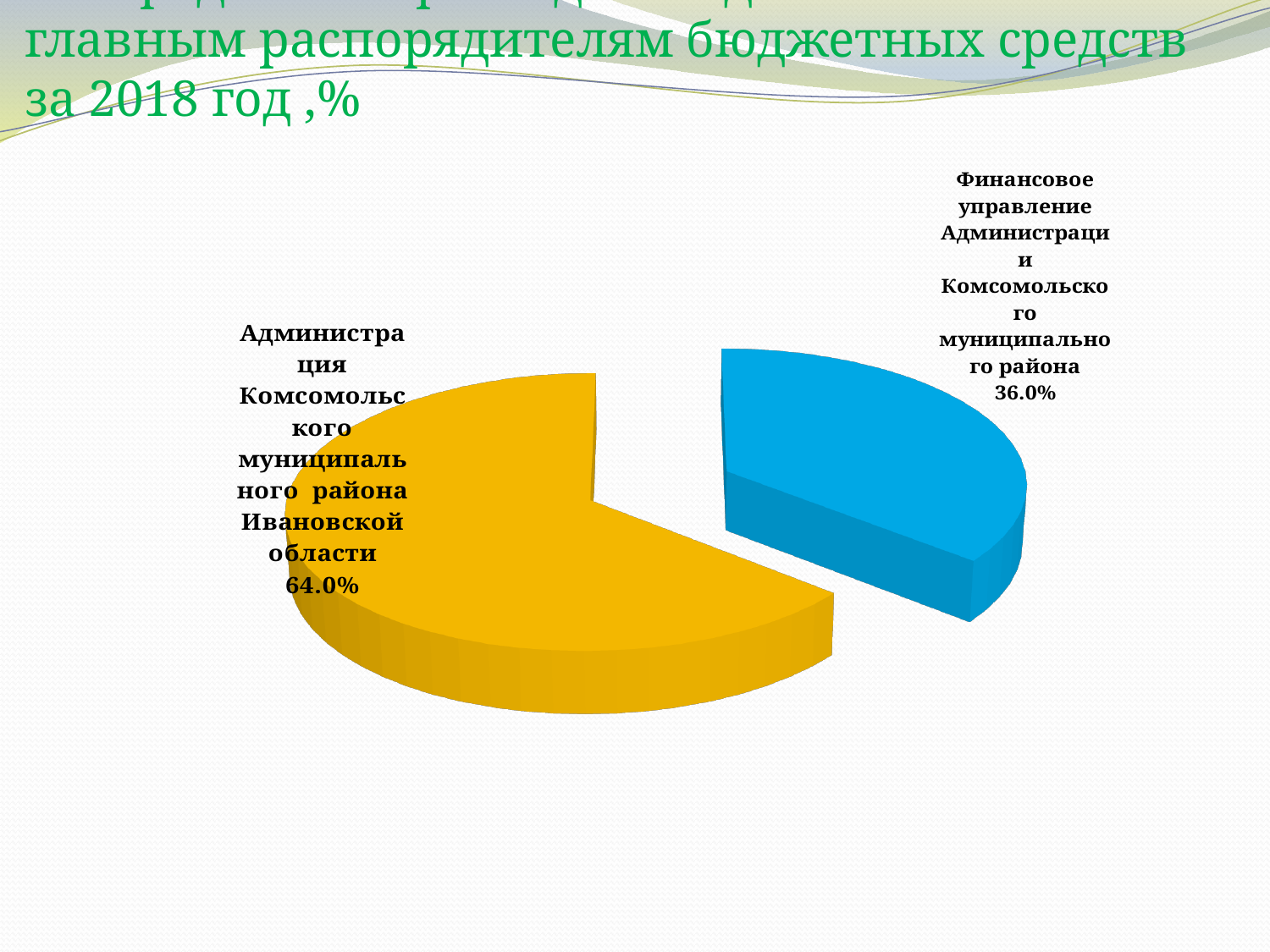
What is the difference in percentage points between the Администрация slice and the Финансовое управление slice? 28.0 Is the share for Финансовое управление Администрации Комсомольского муниципального района greater or less than 50%? less Which slice of the pie chart is the smallest? Финансовое управление Администрации Комсомольского муниципального района Which is larger: the share for Администрация Комсомольского муниципального района Ивановской области or the share for Финансовое управление? Администрация Комсомольского муниципального района Ивановской области What is the total of the two slice percentages shown on the pie chart? 100.0% What kind of chart is shown on the slide? Pie chart What share of the pie is labelled for Финансовое управление Администрации Комсомольского муниципального района? 36.0% What share of the pie is labelled for Администрация Комсомольского муниципального района Ивановской области? 64.0% Which slice of the pie chart is the largest? Администрация Комсомольского муниципального района Ивановской области What colour is the slice representing Администрация Комсомольского муниципального района Ивановской области? Yellow How many slices does the pie chart have? 2 What colour is the slice representing Финансовое управление Администрации Комсомольского муниципального района? Blue